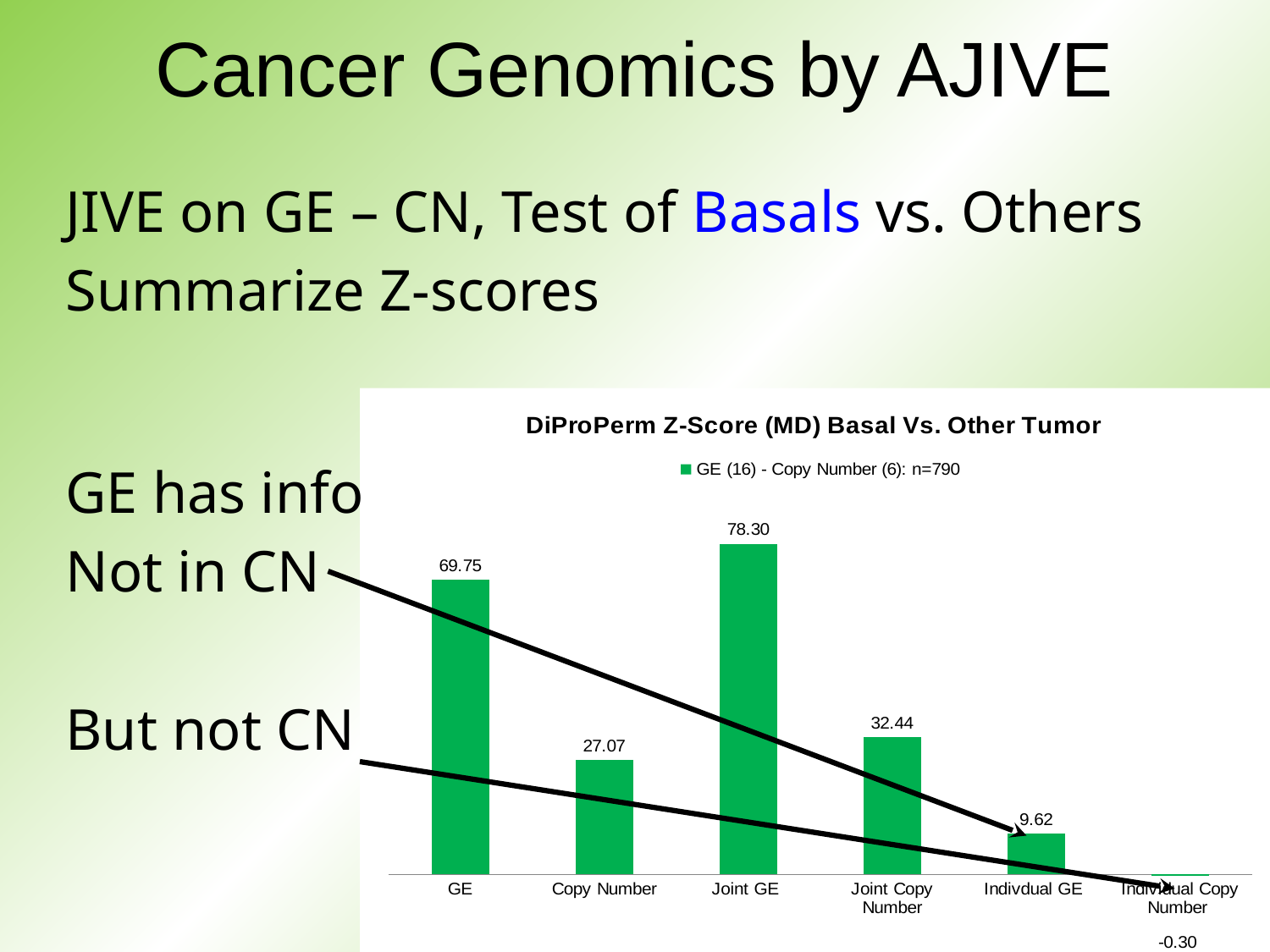
What kind of chart is shown? Bar chart Which is larger, the value for GE or the value for Copy Number? GE What is the difference between the values for Joint Copy Number and Copy Number? 5.37 What is the value for Joint GE? 78.30 How many categories are shown on the x axis? 6 What is the value for Copy Number? 27.07 What is the value for Indivdual GE? 9.62 Which category has the lowest value? Individual Copy Number Which category has the highest value? Joint GE What is the title of the chart? DiProPerm Z-Score (MD) Basal Vs. Other Tumor What is the difference between the values for Joint GE and GE? 8.55 What is the value for Individual Copy Number? -0.30